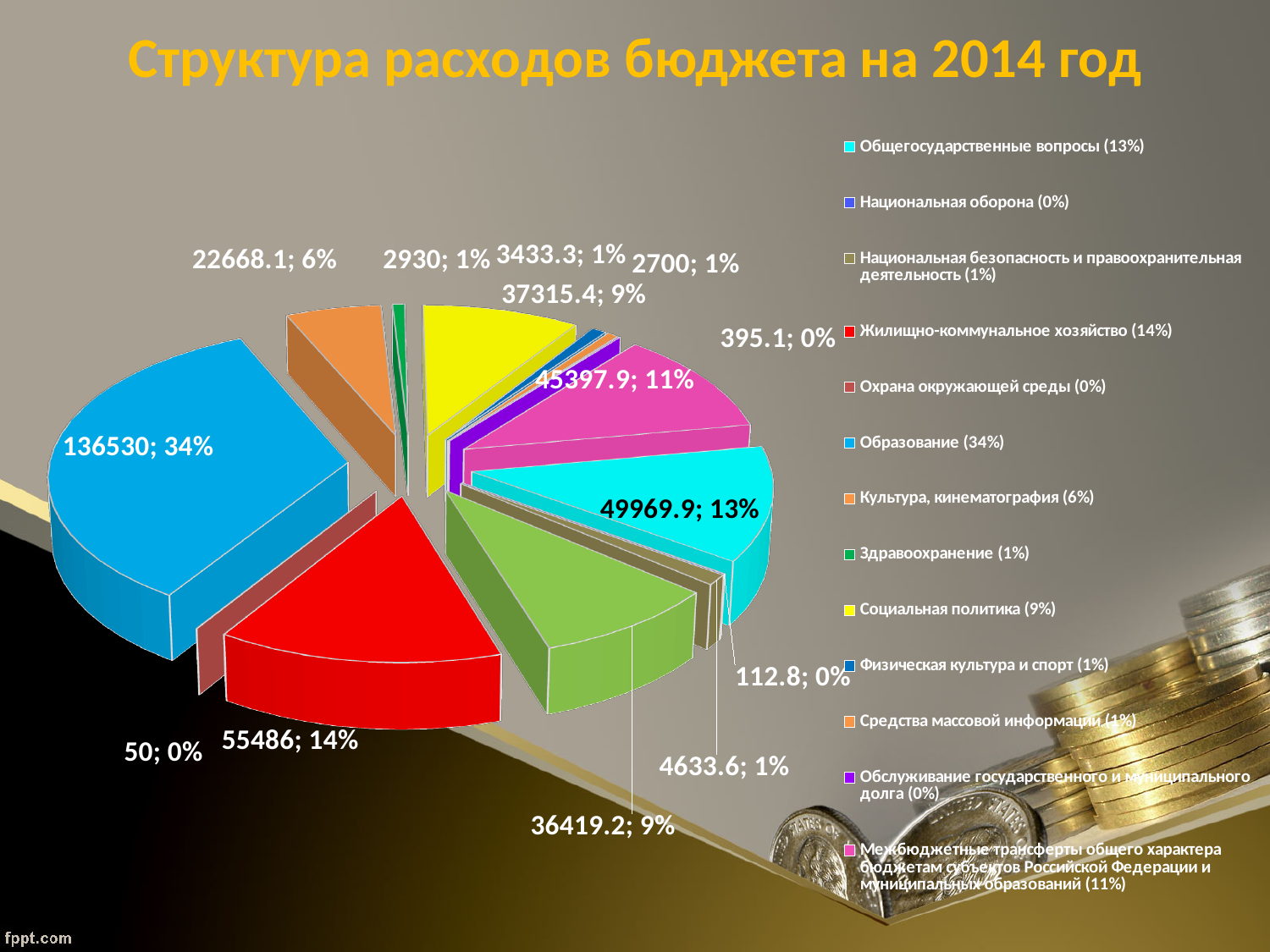
What value is labelled on the Культура, кинематография slice? 22668.1; 6% What value is labelled on the Социальная политика slice? 37315.4; 9% What value is labelled on the Образование slice? 136530; 34% What value is labelled on the Общегосударственные вопросы slice? 49969.9; 13% What is the difference between the value for Образование (136530) and the value for Жилищно-коммунальное хозяйство (55486)? 81044 What is the title of the chart? Структура расходов бюджета на 2014 год Which is larger, the value for Образование or the value for Жилищно-коммунальное хозяйство? Образование What kind of chart is shown on the slide? pie chart What value is labelled on the Жилищно-коммунальное хозяйство slice? 55486; 14% How many entries does the chart legend list? 13 Which category has the largest slice of the pie? Образование What share of the pie does Образование take? 34%